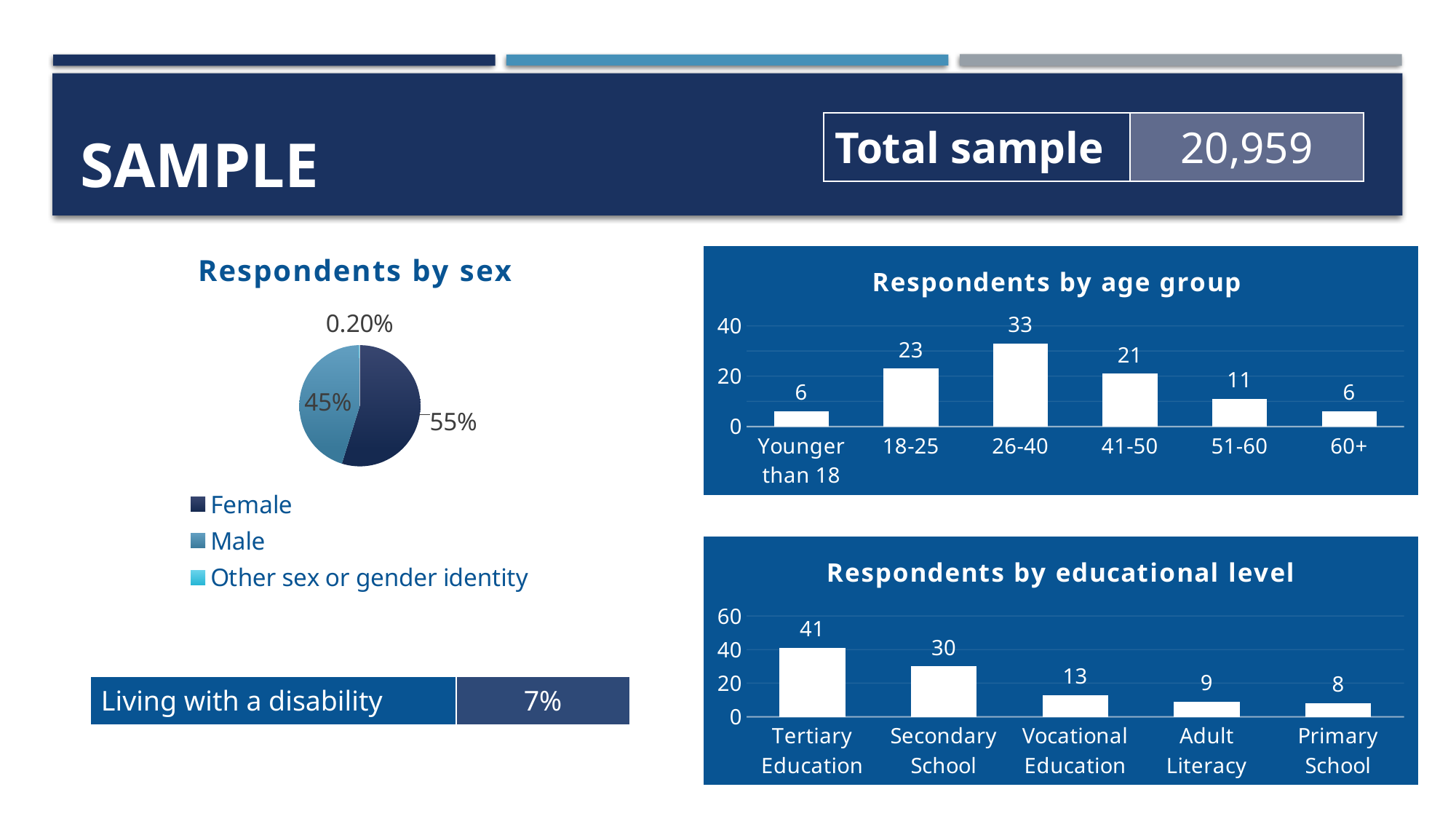
What kind of chart is 'Respondents by educational level'? Bar chart How many age groups are shown in the 'Respondents by age group' chart? 6 In the 'Respondents by age group' chart, what is the difference between the values for 18-25 and 41-50? 2 In the 'Respondents by sex' pie chart, what share is Female? 55% In the 'Respondents by age group' chart, which age group has the highest value? 26-40 In the 'Respondents by educational level' chart, what is the value for Adult Literacy? 9 How many entries does the legend of the 'Respondents by sex' chart list? 3 In the 'Respondents by sex' pie chart, what share is 'Other sex or gender identity'? 0.20% In the 'Respondents by age group' chart, what is the value for 26-40? 33 In the 'Respondents by educational level' chart, which category has the lowest value? Primary School In the 'Respondents by educational level' chart, which is larger: Secondary School or Vocational Education? Secondary School In the 'Respondents by sex' pie chart, what share is Male? 45%